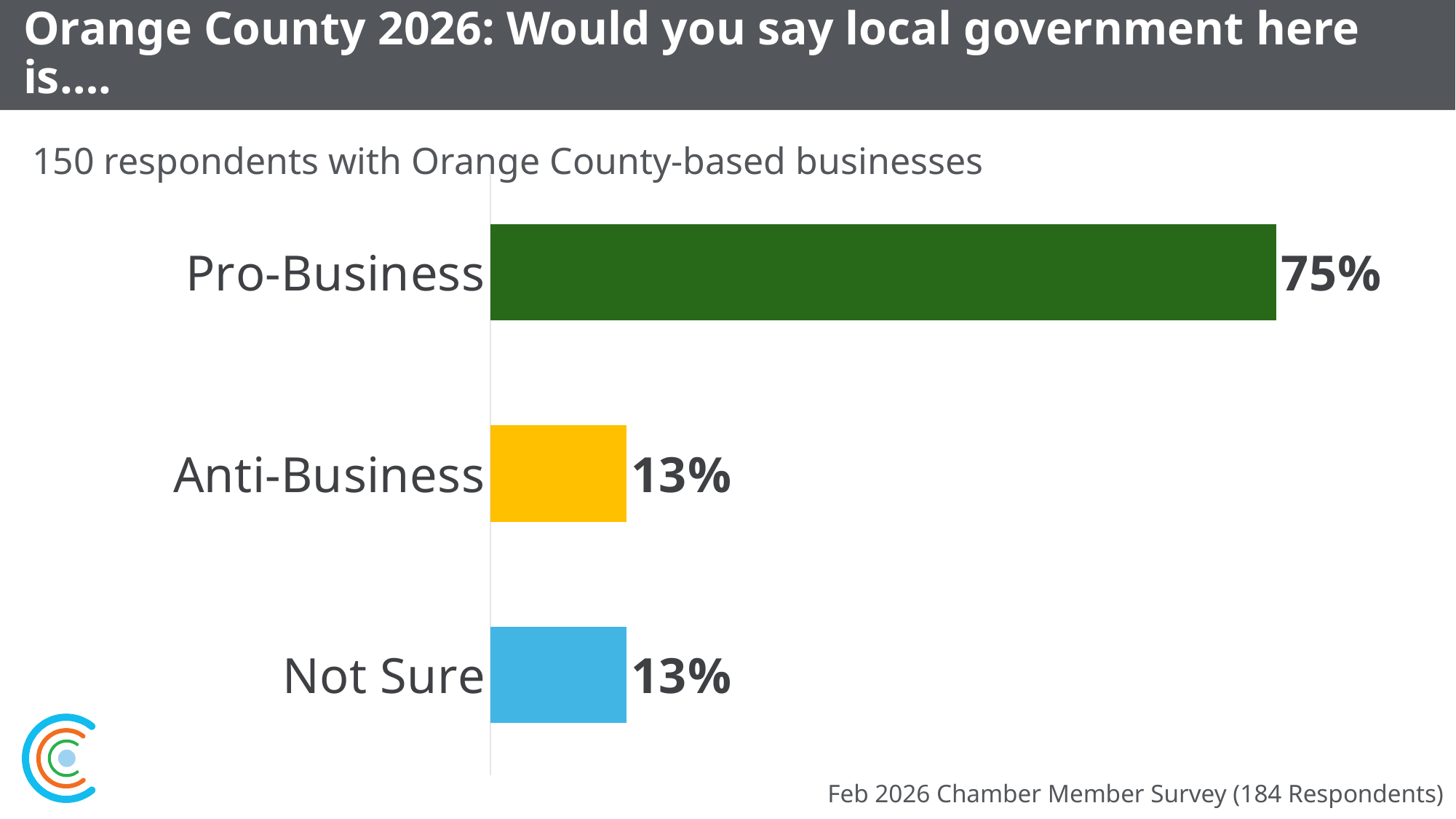
Which category has the highest percentage? Pro-Business How many categories are shown in the chart? 3 What colour is the Pro-Business bar? Green What is the difference in percentage points between Pro-Business and Anti-Business? 62 What kind of chart is shown on the slide? Bar chart Which is larger, the value for Pro-Business or the value for Not Sure? Pro-Business What percentage of respondents answered Not Sure? 13% Do Anti-Business and Not Sure have the same percentage? Yes What percentage of respondents said local government is Pro-Business? 75% What percentage of respondents said local government is Anti-Business? 13% How many respondents with Orange County-based businesses does the chart subtitle mention? 150